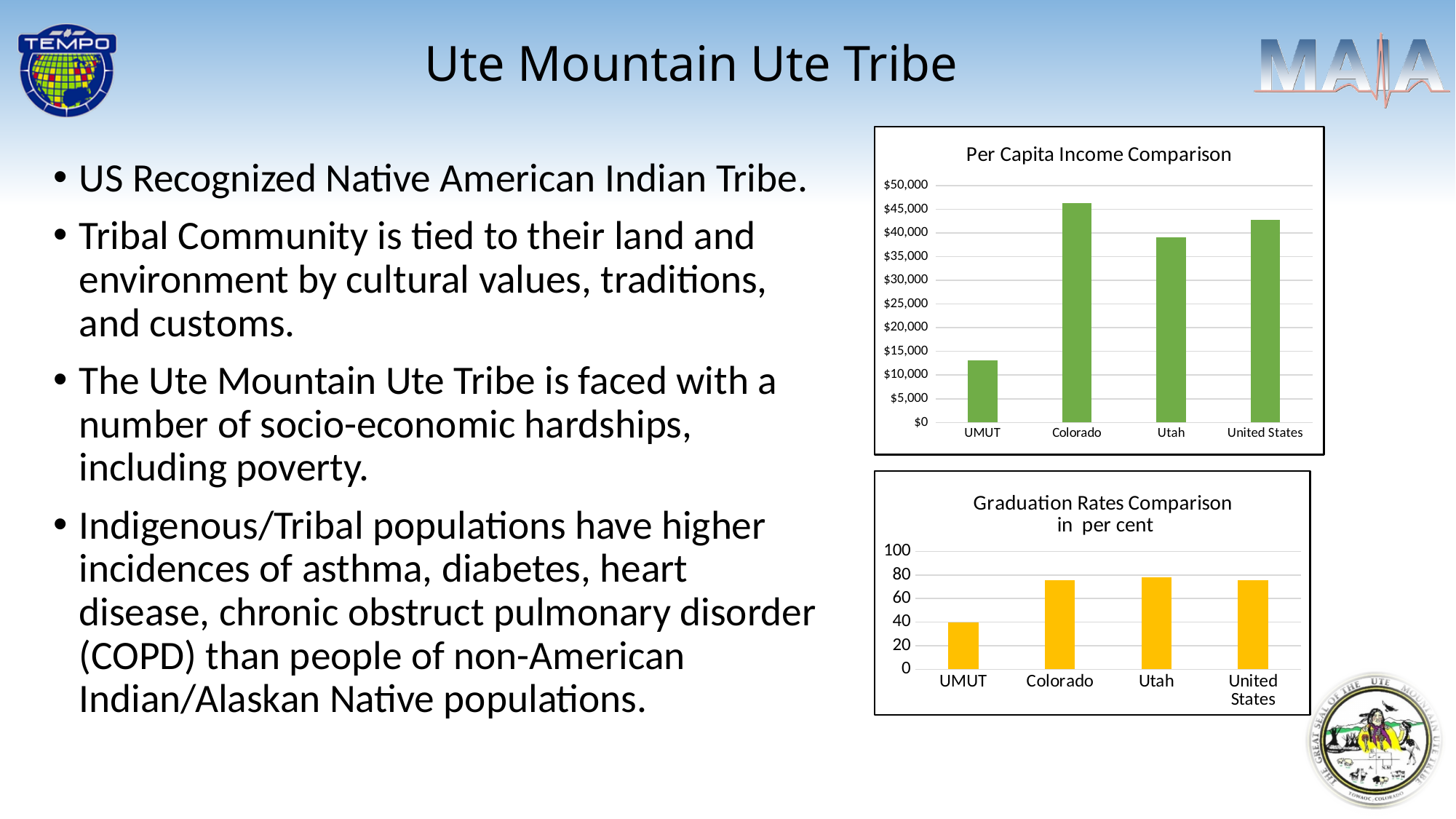
In the Graduation Rates Comparison chart, which category has the lowest graduation rate? UMUT How many categories are shown in the Per Capita Income Comparison chart? 4 In the Graduation Rates Comparison chart, is the value for Colorado greater or less than 60? greater In the Per Capita Income Comparison chart, which category has the lowest per capita income? UMUT In the Per Capita Income Comparison chart, is the value for UMUT greater or less than $15,000? less In the Graduation Rates Comparison chart, is the value for UMUT greater or less than 60? less What colour are the bars in the Graduation Rates Comparison chart? yellow What kind of chart is the Per Capita Income Comparison chart? bar chart In the Per Capita Income Comparison chart, which is larger, the value for Utah or the value for United States? United States In the Per Capita Income Comparison chart, which category has the highest per capita income? Colorado